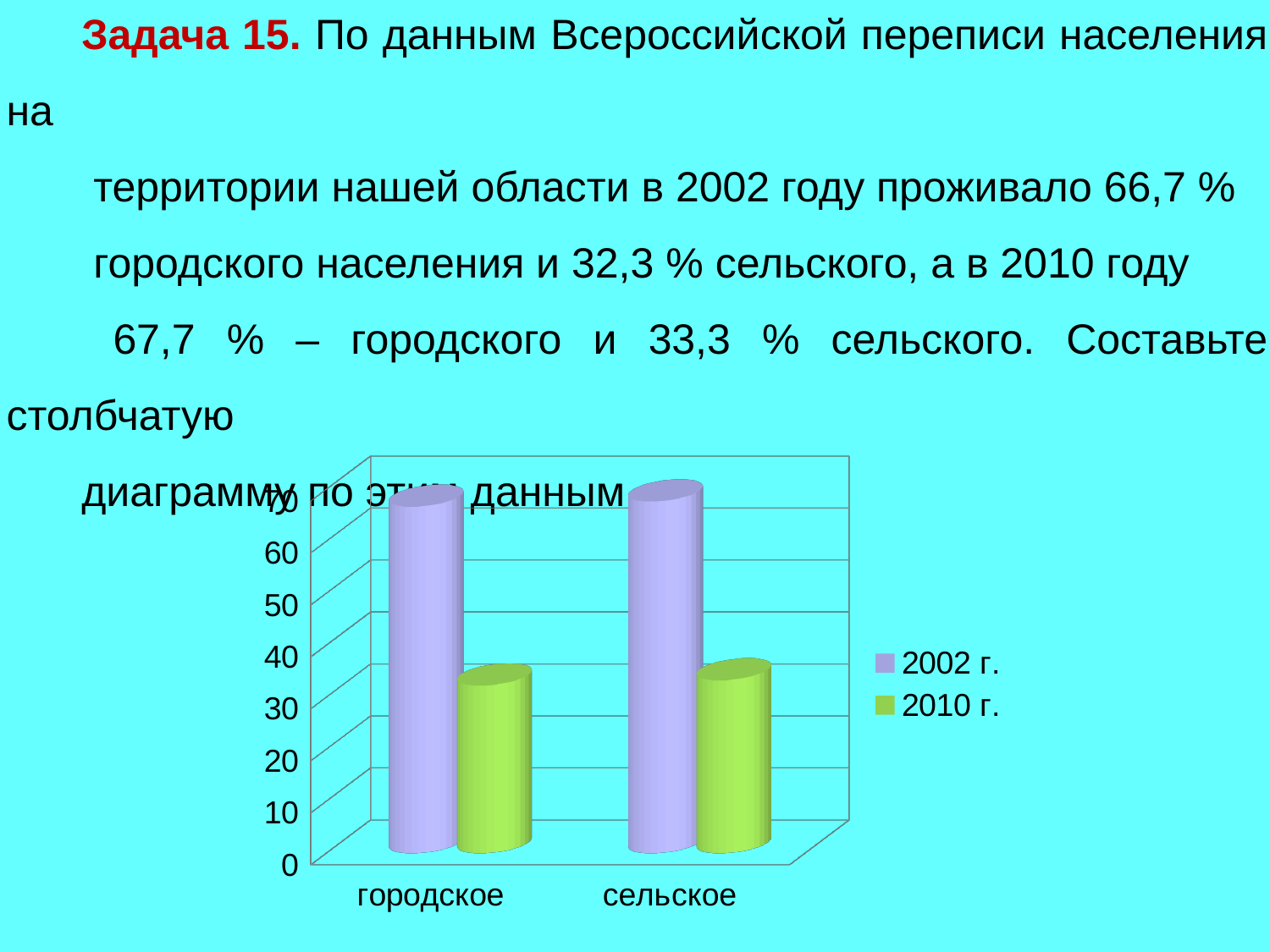
What colour are the bars for the 2010 г. series? green In the сельское category, which series has the larger value, 2002 г. or 2010 г.? 2002 г. Is the value for 2002 г. in the сельское category greater or less than 60? greater What kind of chart is shown on the slide? bar chart In the городское category, which series has the larger value, 2002 г. or 2010 г.? 2002 г. How many series does the chart legend list? 2 Is the value for 2002 г. in the городское category greater or less than 60? greater Is the value for 2010 г. in the сельское category greater or less than 40? less What are the two series listed in the chart legend? 2002 г. and 2010 г. How many categories are shown on the x axis of the chart? 2